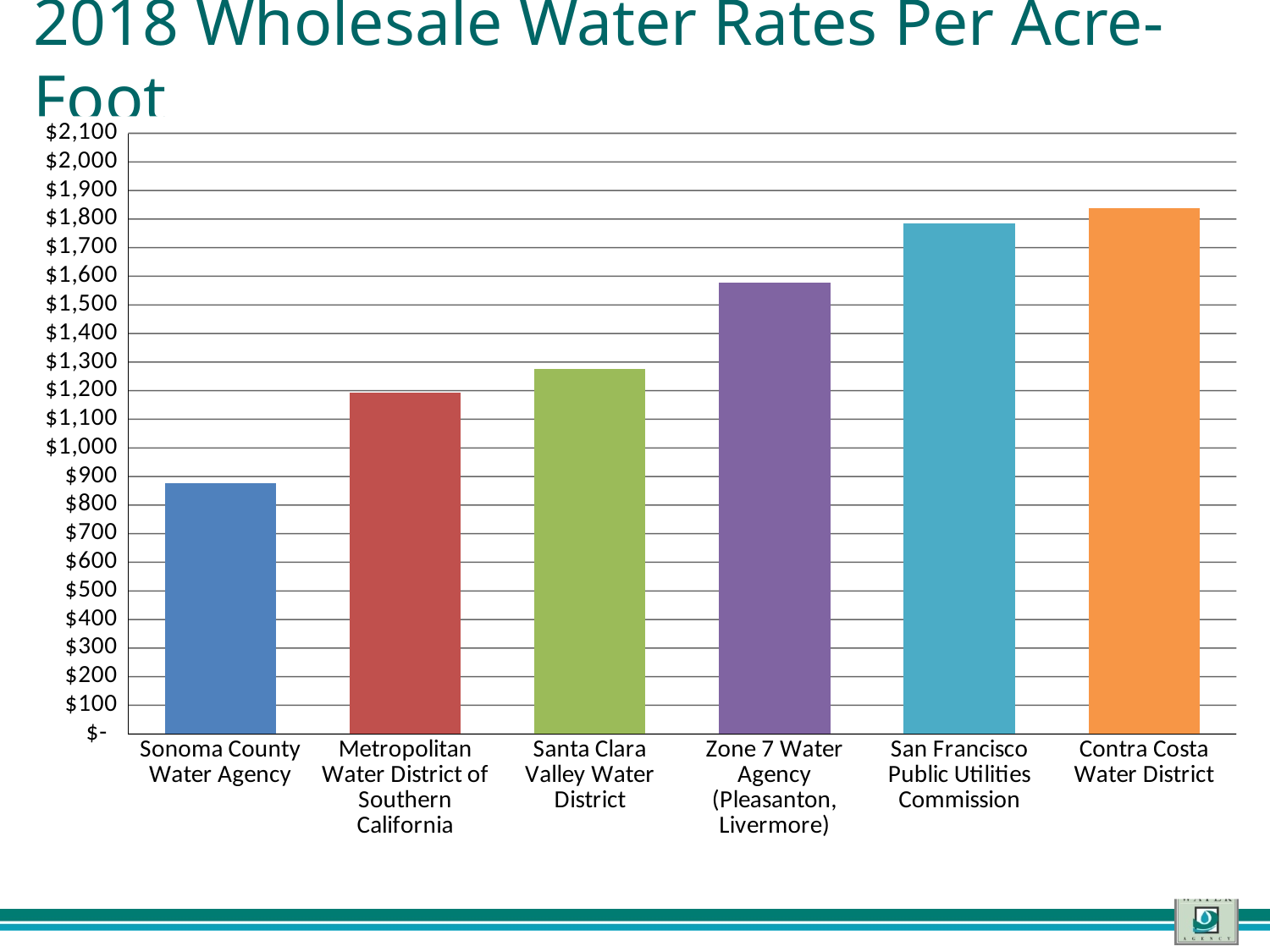
Which agency has the lowest 2018 wholesale water rate per acre-foot? Sonoma County Water Agency What kind of chart is shown on the slide? bar chart Is the value for Contra Costa Water District greater or less than $1,900? less Which agency has the highest 2018 wholesale water rate per acre-foot? Contra Costa Water District Is the value for Sonoma County Water Agency greater or less than $1,000? less Is the value for Santa Clara Valley Water District greater or less than $1,400? less How many agencies are shown on the chart? 6 Which has a higher rate, Zone 7 Water Agency (Pleasanton, Livermore) or Santa Clara Valley Water District? Zone 7 Water Agency (Pleasanton, Livermore) Do the bar values rise or fall from left to right across the chart? rise